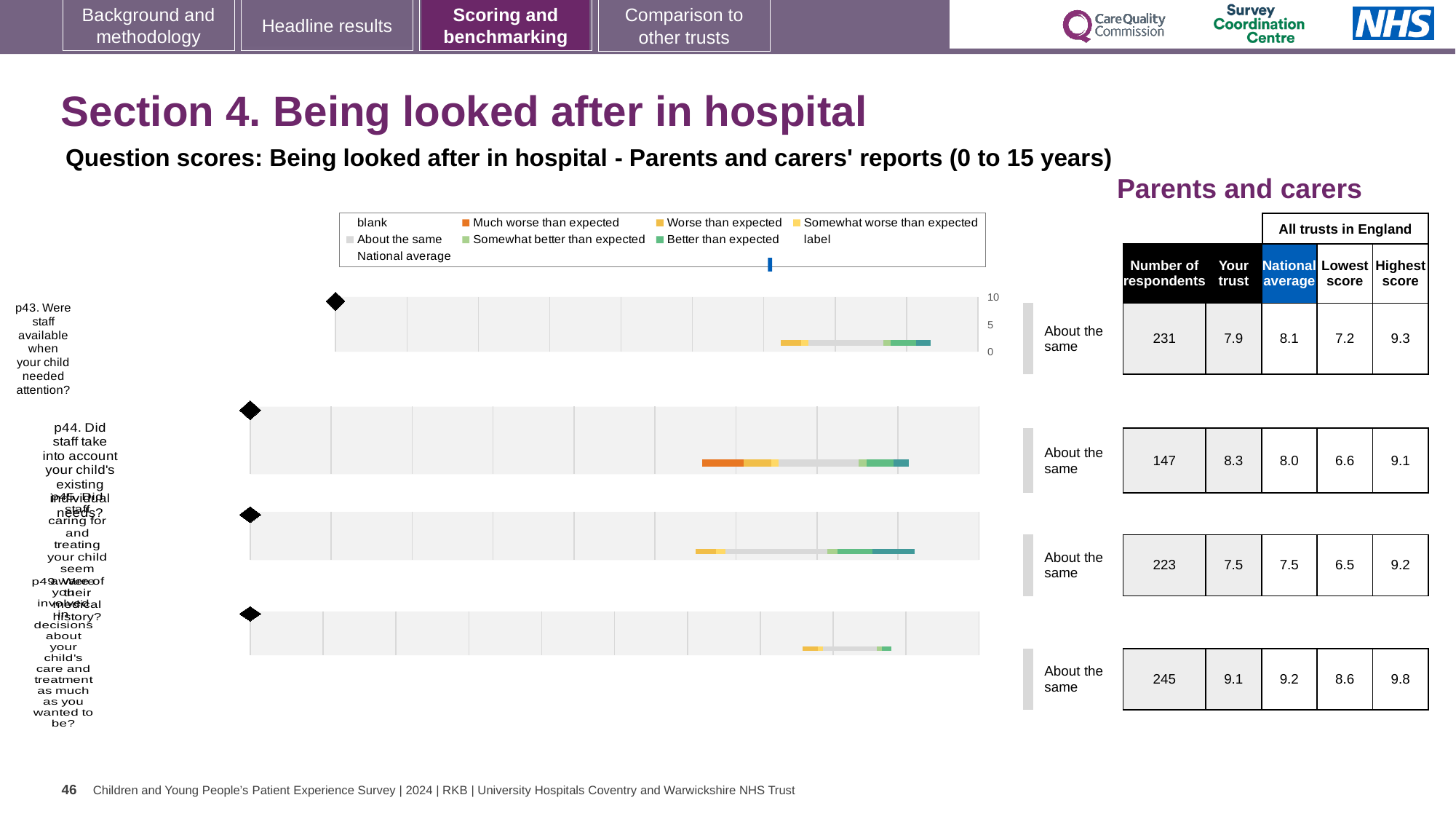
For question p43, what is the difference between the highest score (9.3) and the lowest score (7.2) across all trusts in England? 2.1 What benchmark category is shown for all four questions on the slide? About the same For question p49, what is the highest score among all trusts in England? 9.8 For question p43, what is the national average score? 8.1 Which question has the lowest 'Your trust' score? p45 What kind of chart is used to show the question scores on this slide? bar chart For question p44, how many respondents are reported? 147 For question p43 (Were staff available when your child needed attention?), what is the 'Your trust' score? 7.9 How many survey questions (p43, p44, p45, p49) are plotted on the slide? 4 For question p44, is the 'Your trust' score or the national average higher? Your trust Which question has the highest 'Your trust' score? p49 Which question has the largest number of respondents? p49